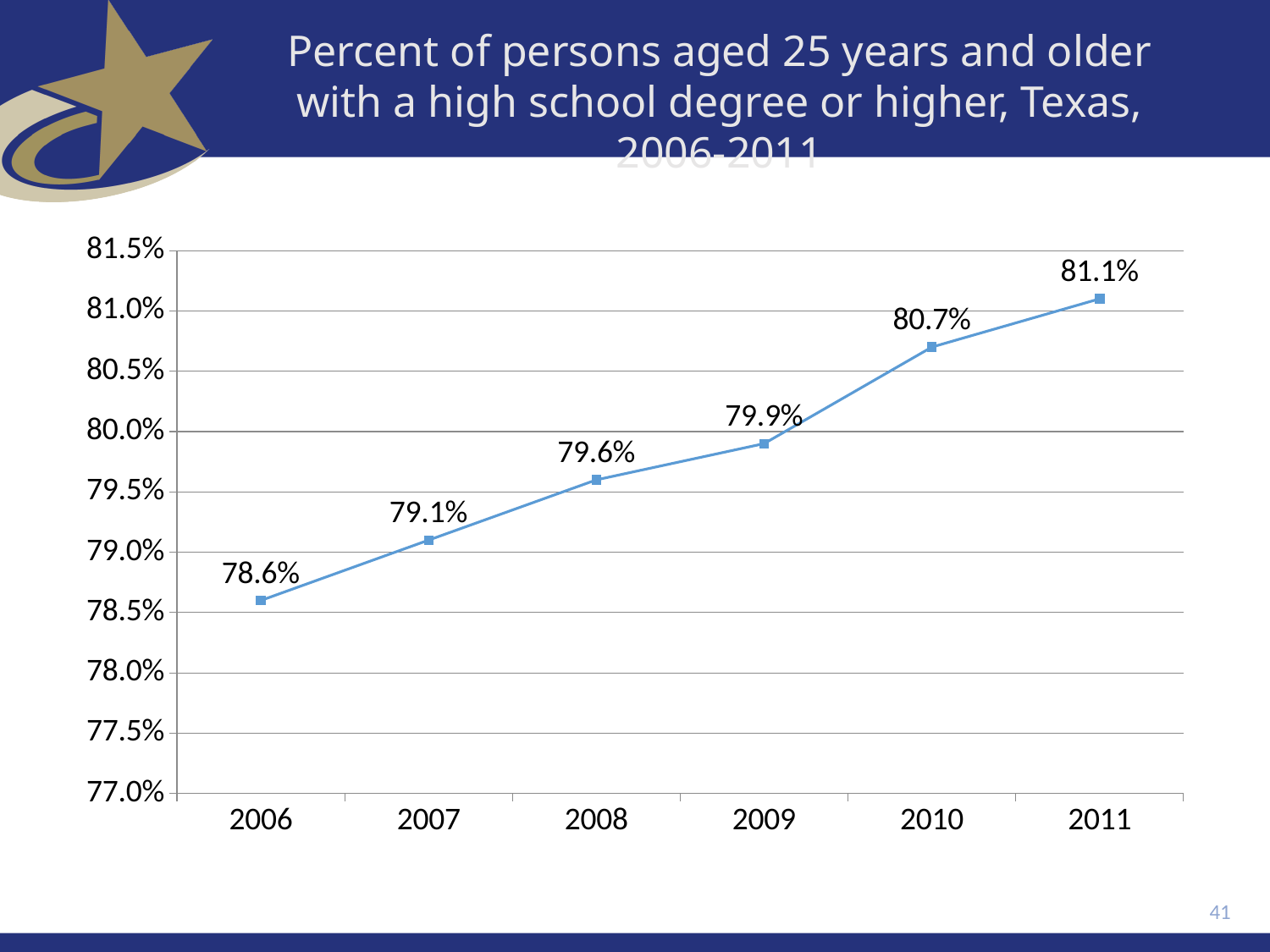
Which is larger, the value for 2008 or the value for 2010? 2010 What kind of chart is shown on the slide? line chart What is the difference between the values for 2010 and 2009? 0.8 percentage points What is the value for 2011? 81.1% Which year has the highest value? 2011 Which year has the lowest value? 2006 Is the value for 2007 greater or less than 79.5%? less What is the value for 2006? 78.6% How many years are plotted on the chart? 6 What is the value for 2009? 79.9% What is the difference between the values for 2011 and 2006? 2.5 percentage points Do the values rise or fall from 2006 to 2011? rise